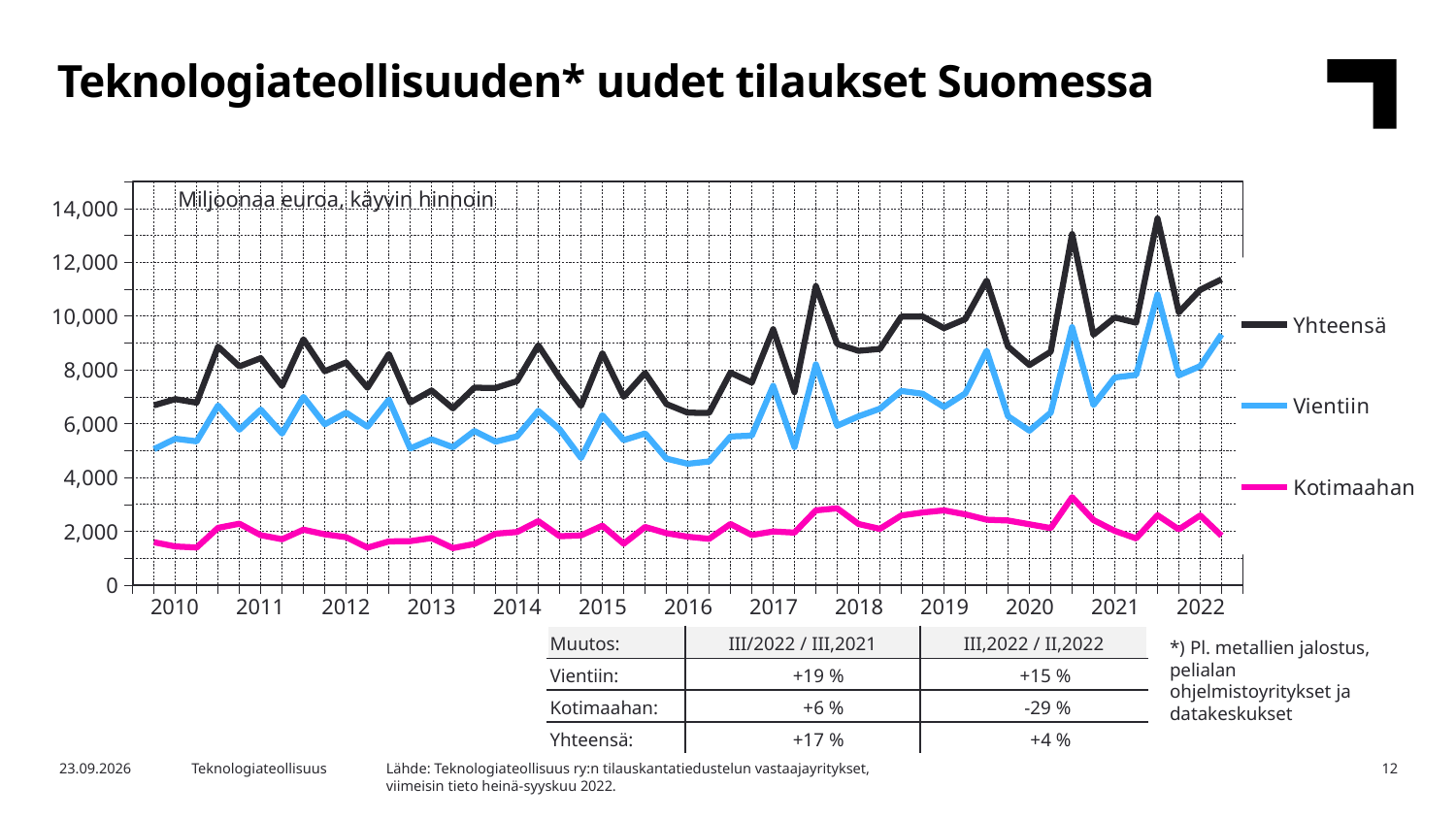
Does the Yhteensä line overall rise or fall from 2010 to 2022? rise Which series has the lowest values throughout the chart? Kotimaahan Which is larger at the end of 2022, Vientiin or Kotimaahan? Vientiin Is the value for Kotimaahan at the start of 2010 greater or less than 4,000? less Is the peak value for Yhteensä in 2021 greater or less than 12,000? greater Is the value for Vientiin at the start of 2016 greater or less than 6,000? less Which series has the highest values throughout the chart? Yhteensä What kind of chart is shown on the slide? line chart Which series is shown in black in the legend? Yhteensä How many years are labelled on the x axis? 13 How many series does the legend list? 3 What unit is stated in the label at the top of the chart? Miljoonaa euroa, käyvin hinnoin